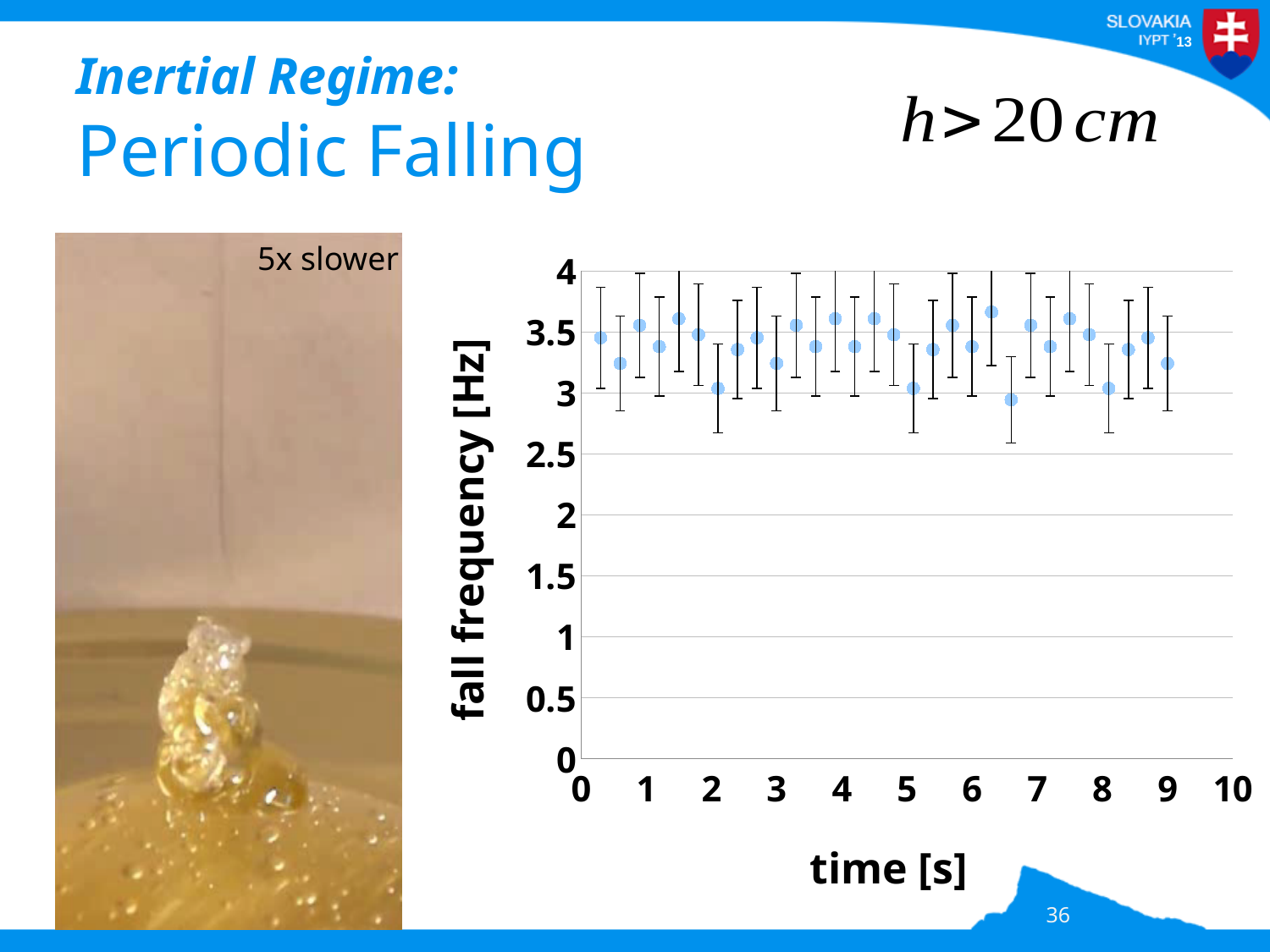
Is the fall frequency at about 0.3 s greater or less than 2.5? greater Are all plotted fall frequency values greater or less than 2.5 Hz? greater What is the label of the x axis of the chart? time [s] Is the fall frequency at about 6.6 s greater or less than 3.5? less What kind of chart is shown on the slide? scatter chart What is the label of the y axis of the chart? fall frequency [Hz] Does the fall frequency show a clear rising or falling trend over time, or does it stay roughly constant? roughly constant